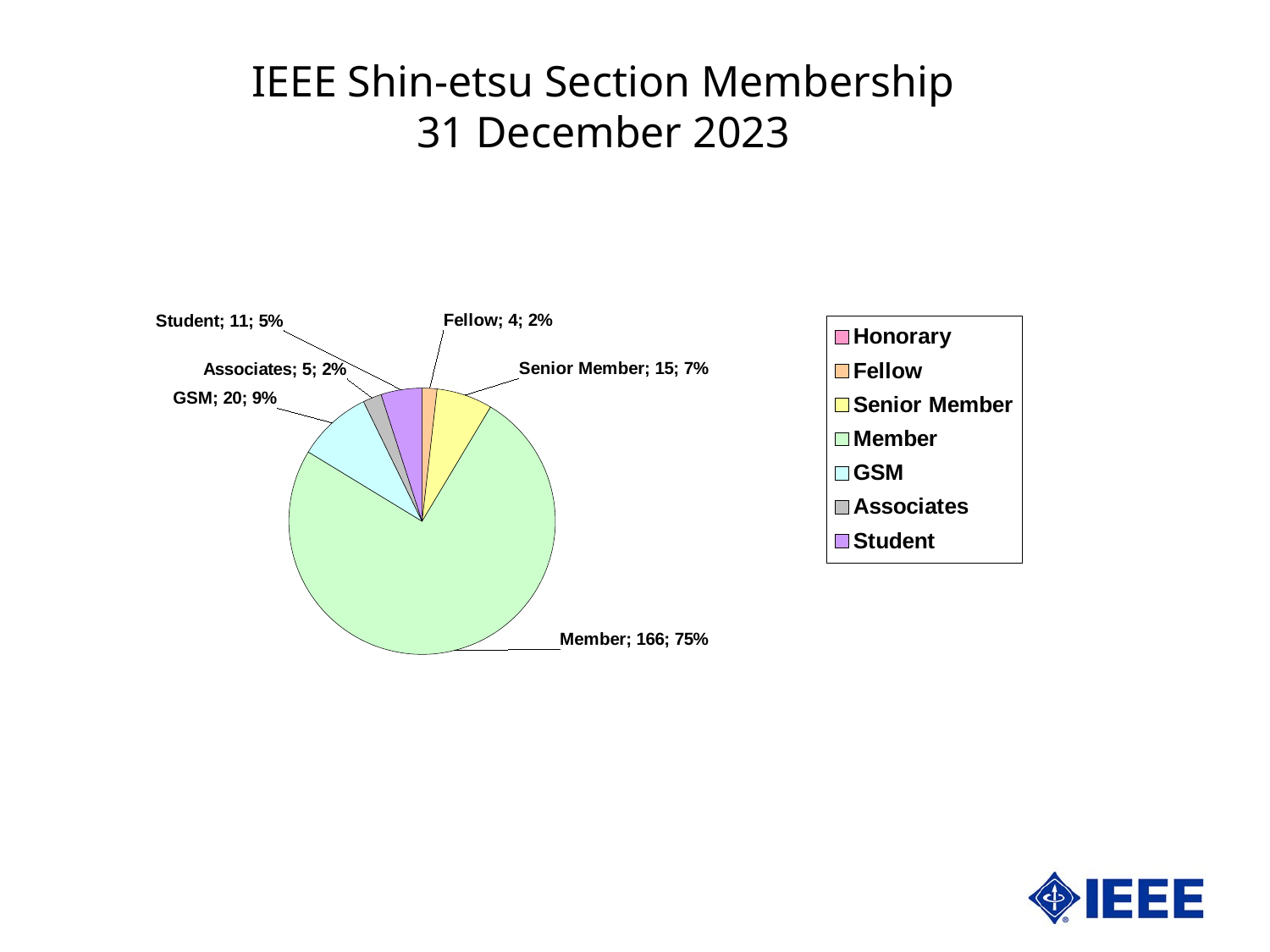
What share of the pie does the Member slice represent? 75% Which is larger, the Student count or the Associates count? Student What is the difference between the Member count and the GSM count? 146 Which labelled category has the smallest count? Fellow How many entries does the legend list? 7 What is the difference between the Senior Member count and the Student count? 4 What kind of chart is shown on the slide? pie chart Which category has the largest slice of the pie? Member What percentage of the membership is Senior Member? 7% How many members are in the GSM category? 20 How many members are in the Member category? 166 What is the title of the slide containing the chart? IEEE Shin-etsu Section Membership 31 December 2023